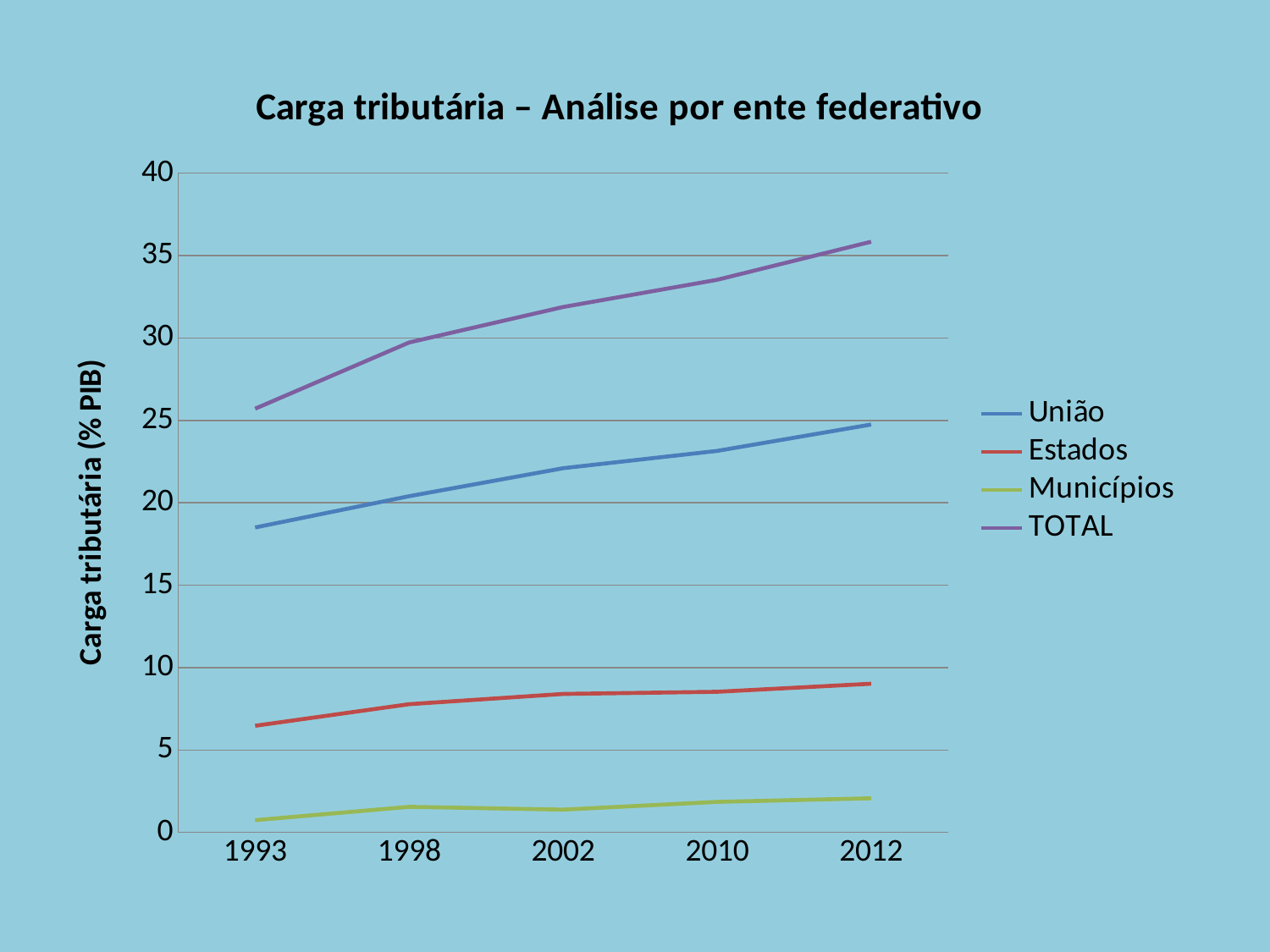
Is the value for TOTAL in 2002 greater or less than 30? greater Which is larger in 2012, the value for União or the value for Estados? União Is the value for União in 1993 greater or less than 20? less Which series has the lowest values across all years? Municípios Which series has the highest values across all years? TOTAL What is the label of the vertical axis? Carga tributária (% PIB) How many years are shown on the x axis? 5 Does the TOTAL series rise or fall from 1993 to 2012? rise How many series does the legend list? 4 What kind of chart is shown on the slide? line chart Is the value for Estados in 2012 greater or less than 10? less